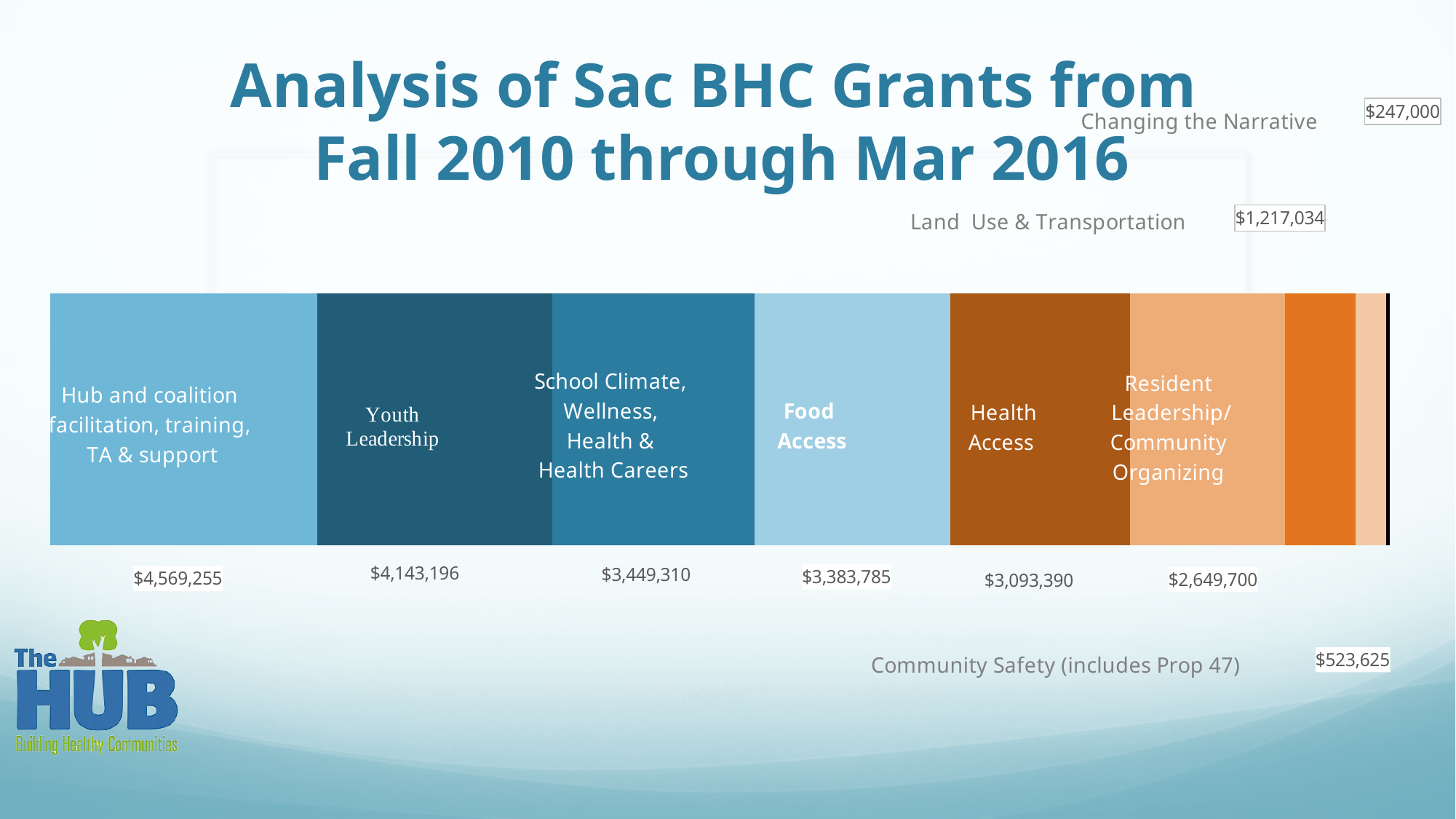
What is the grant amount for Youth Leadership? $4,143,196 What is the grant amount for Land Use & Transportation? $1,217,034 How many grant categories are shown in the chart? 9 What is the difference between the grant amounts for Food Access and Health Access? $290,395 What is the grant amount for Food Access? $3,383,785 What is the difference between the grant amounts for Hub and coalition facilitation, training, TA & support and Youth Leadership? $426,059 What is the grant amount for Hub and coalition facilitation, training, TA & support? $4,569,255 Which received more grant funding, Resident Leadership/Community Organizing or Community Safety (includes Prop 47)? Resident Leadership/Community Organizing Which category received the largest grant amount? Hub and coalition facilitation, training, TA & support What is the grant amount for Changing the Narrative? $247,000 What type of chart is shown on the slide? Stacked bar chart Which category received the smallest grant amount? Changing the Narrative